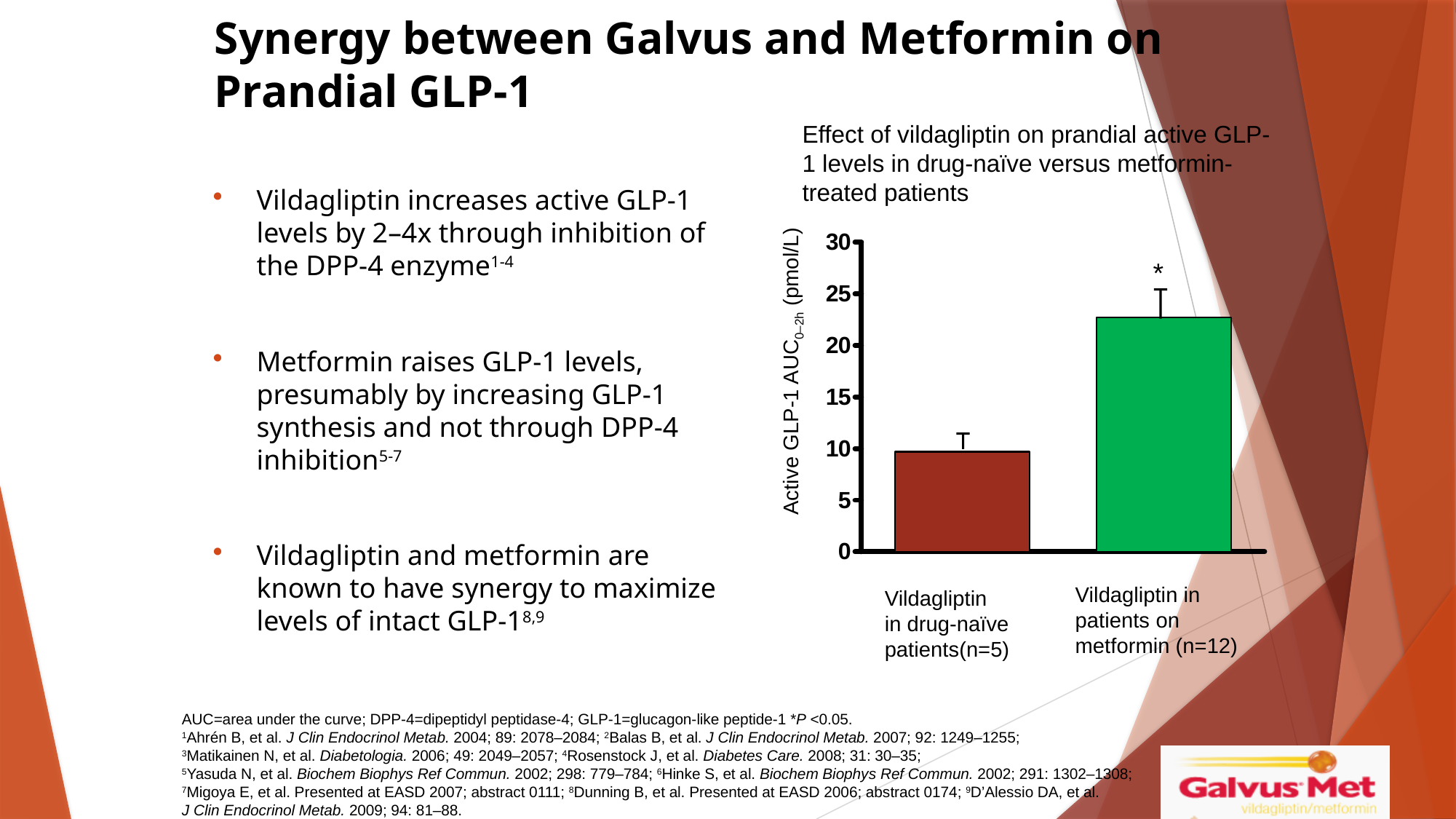
What is the y-axis label of the chart? Active GLP-1 AUC0–2h (pmol/L) Which group has the higher active GLP-1 AUC0–2h value? Vildagliptin in patients on metformin (n=12) How many patients were in the metformin-treated group shown in the chart? 12 Is the value for vildagliptin in patients on metformin greater or less than 25? less What kind of chart is shown on the slide? bar chart How many bars are plotted in the chart? 2 Which group has the lower active GLP-1 AUC0–2h value? Vildagliptin in drug-naïve patients (n=5) Is the value for vildagliptin in drug-naïve patients greater or less than 5? greater Which is larger: the value for drug-naïve patients or the value for patients on metformin? patients on metformin Is the value for vildagliptin in patients on metformin greater or less than 20? greater What is the maximum value shown on the y axis of the chart? 30